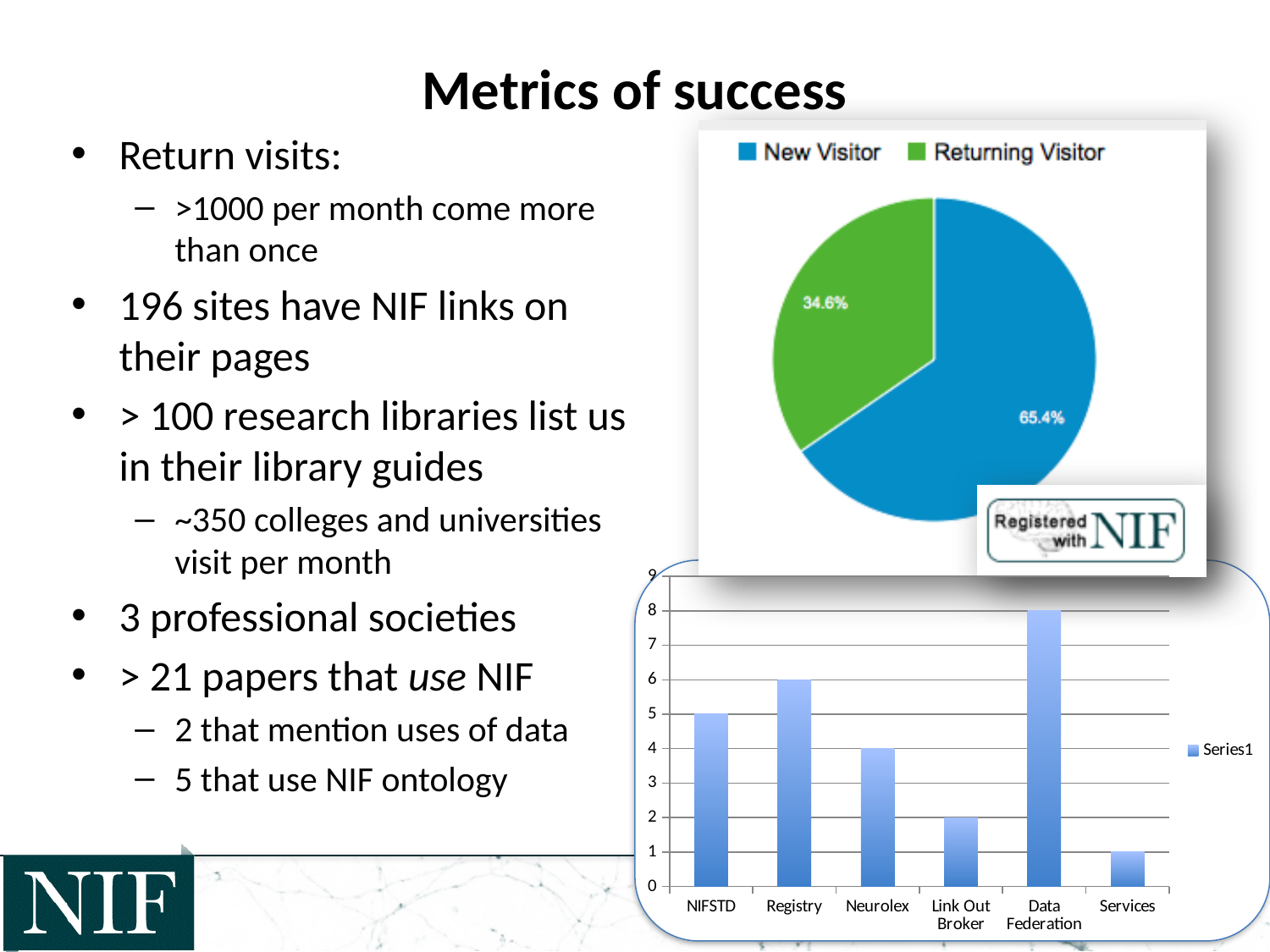
In the bar chart at the bottom right, what is the value for Registry? 6 How many entries does the legend of the pie chart list? 2 In the bar chart at the bottom right, what is the value for Data Federation? 8 In the bar chart at the bottom right, which category has the highest value? Data Federation In the pie chart, what share of visitors are Returning Visitors? 34.6% What kind of chart is the chart at the bottom right of the slide? Bar chart In the bar chart at the bottom right, which category has the lowest value? Services In the bar chart at the bottom right, is the value for Neurolex greater or less than 5? less How many categories are shown on the x axis of the bar chart at the bottom right? 6 In the bar chart at the bottom right, what is the difference between the values for NIFSTD and Link Out Broker? 3 In the pie chart, what share of visitors are New Visitors? 65.4% In the pie chart, which slice is larger, New Visitor or Returning Visitor? New Visitor